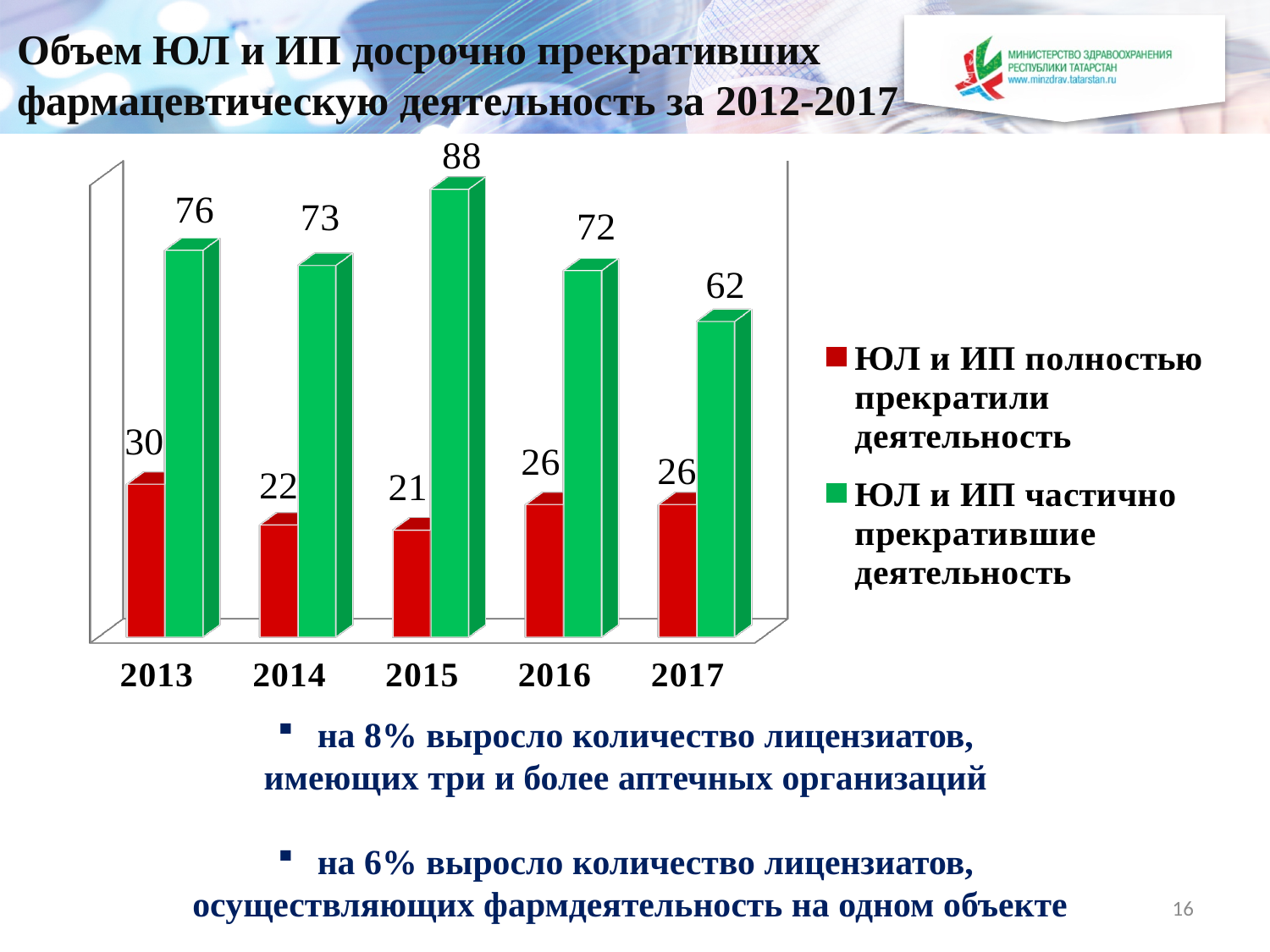
What is the value for 'ЮЛ и ИП частично прекратившие деятельность' in 2015? 88 How many years are shown on the x axis of the chart? 5 In which year is the value for 'ЮЛ и ИП частично прекратившие деятельность' highest? 2015 What is the value for 'ЮЛ и ИП полностью прекратили деятельность' in 2013? 30 Which is larger: the 'ЮЛ и ИП полностью прекратили деятельность' value for 2013 or for 2014? 2013 What kind of chart is shown on the slide? bar chart What is the difference between the 'ЮЛ и ИП частично прекратившие деятельность' values for 2015 and 2017? 26 In which year is the value for 'ЮЛ и ИП полностью прекратили деятельность' lowest? 2015 What colour are the bars for 'ЮЛ и ИП полностью прекратили деятельность'? red How many series does the legend list? 2 What is the value for 'ЮЛ и ИП частично прекратившие деятельность' in 2017? 62 Does the value for 'ЮЛ и ИП частично прекратившие деятельность' rise or fall from 2015 to 2017? fall